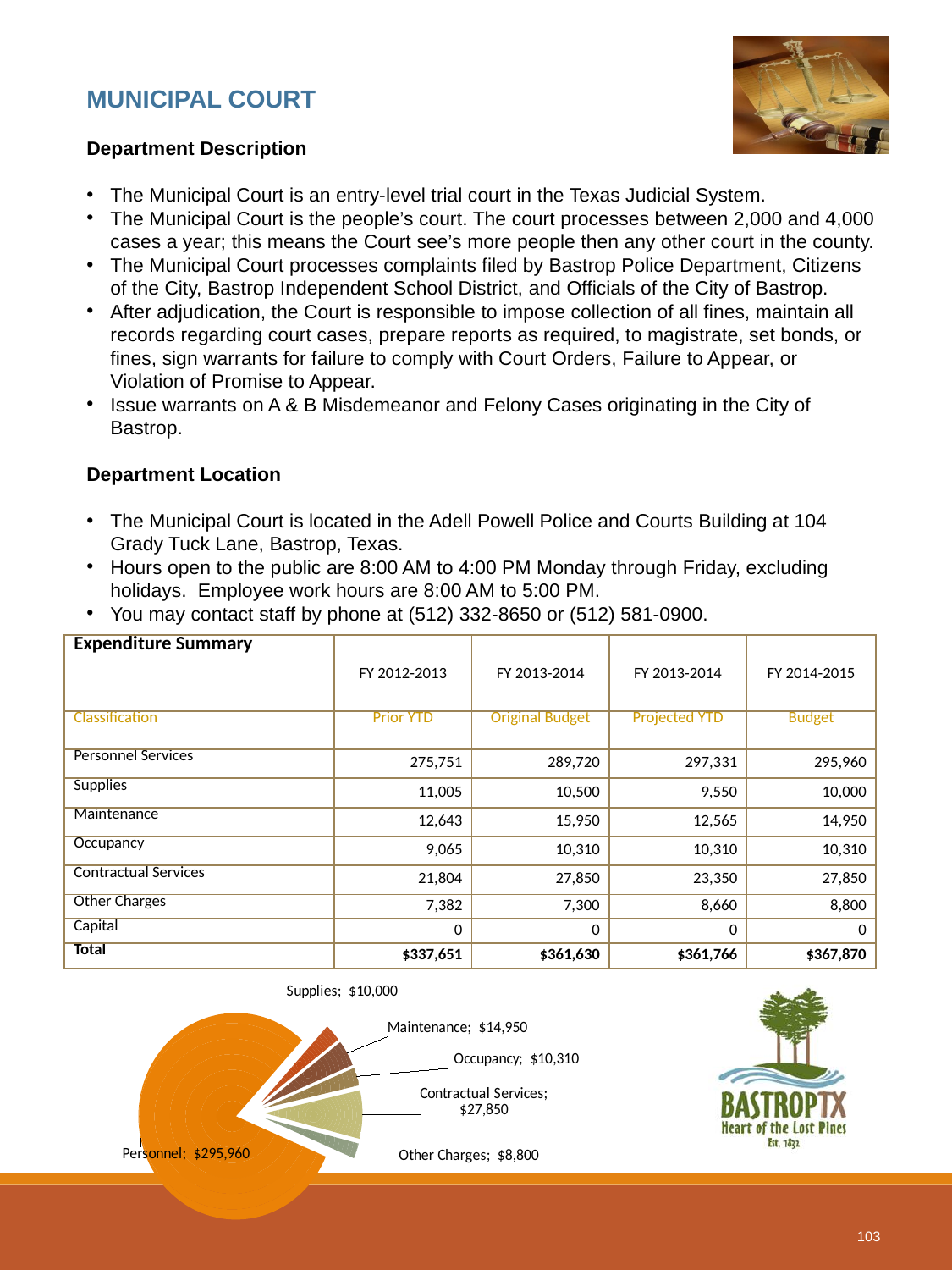
Which category has the smallest value in the pie chart? Other Charges In the pie chart, which is larger: Contractual Services or Maintenance? Contractual Services What is the value shown for Contractual Services in the pie chart? $27,850 What is the value shown for Maintenance in the pie chart? $14,950 How many slices does the pie chart have? 6 What is the difference between the Supplies and Other Charges values in the pie chart? $1,200 What is the value shown for Occupancy in the pie chart? $10,310 What kind of chart is shown at the bottom of the slide? Pie chart Which category has the largest slice in the pie chart? Personnel What is the difference between the Contractual Services and Maintenance values in the pie chart? $12,900 What is the value shown for Personnel in the pie chart? $295,960 What is the value shown for Other Charges in the pie chart? $8,800